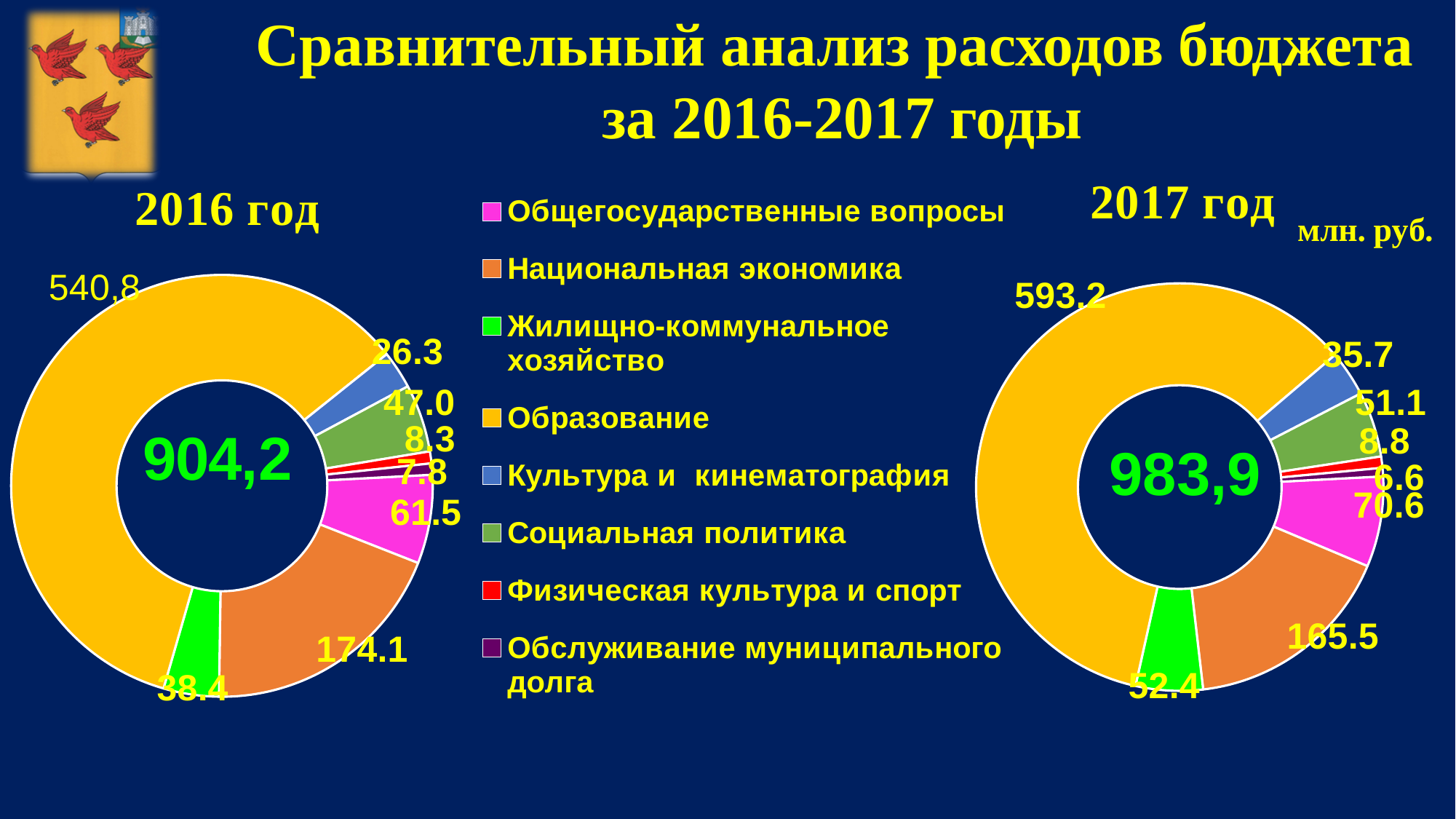
In the 2016 год chart, what is the value for Национальная экономика? 174.1 How many categories does the legend list? 8 What total is shown in the centre of the 2017 год chart? 983,9 In the 2017 год chart, what is the value for Жилищно-коммунальное хозяйство? 52.4 In the 2016 год chart, what is the value for Образование? 540,8 What type of chart is used for the 2016 год chart? doughnut (pie) chart In the 2016 год chart, which category has the smallest value? Обслуживание муниципального долга In the 2017 год chart, what is the value for Общегосударственные вопросы? 70.6 What is the difference between the Образование values in the 2017 год chart and the 2016 год chart? 52.4 In the 2017 год chart, what is the value for Образование? 593.2 In the 2016 год chart, which category has the largest value? Образование Which is larger: Национальная экономика in the 2016 год chart or in the 2017 год chart? 2016 год (174.1)